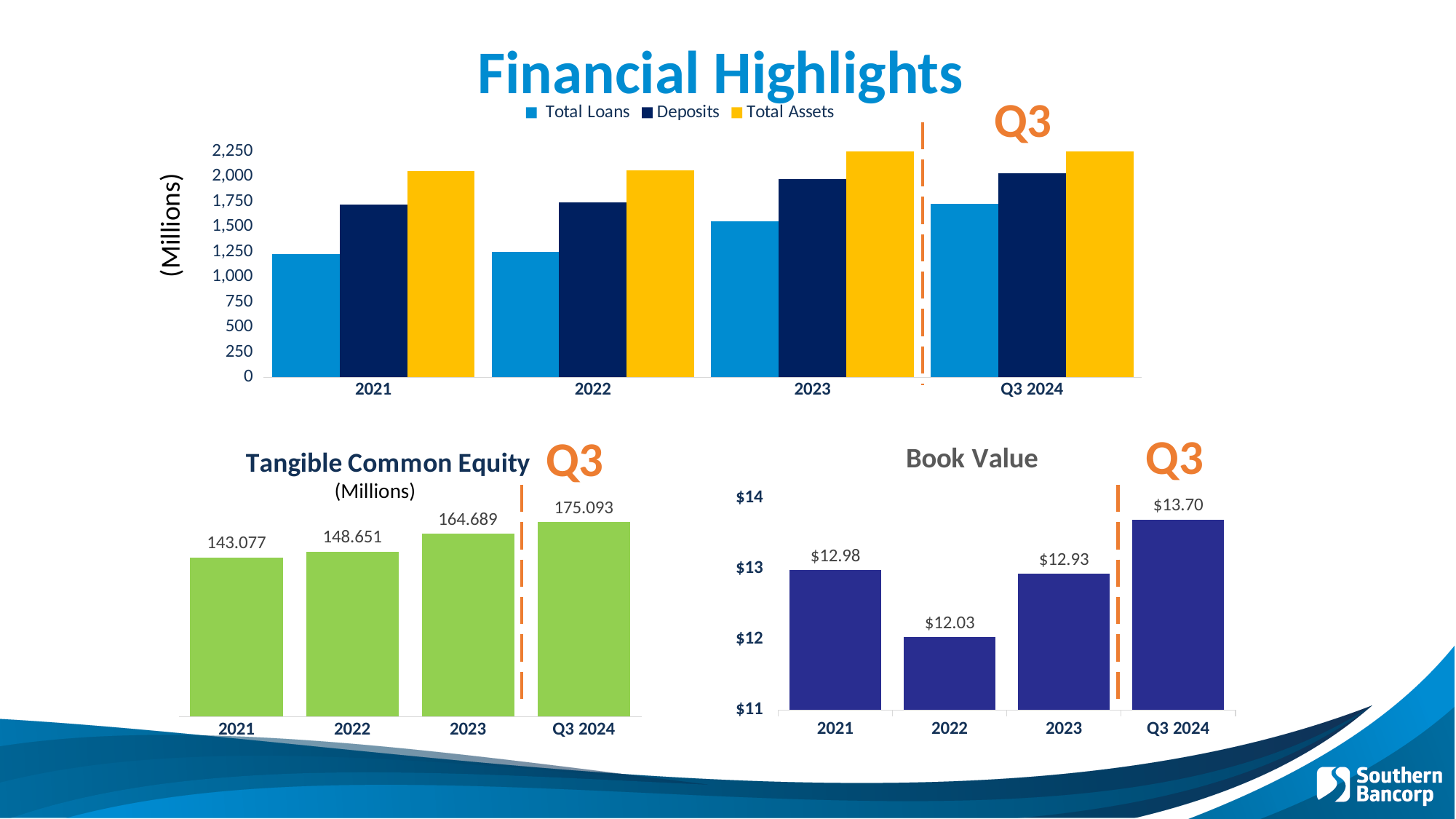
In the Tangible Common Equity chart, what is the value for 2021? 143.077 In the Financial Highlights chart at the top, is the Total Loans value for 2021 greater or less than 1,500? less In the Financial Highlights chart at the top, how many series does the legend list? 3 In the Tangible Common Equity chart, what is the difference between the 2023 and 2022 values? 16.038 What kind of chart is the Book Value chart? bar chart In the Book Value chart, which period has the lowest value? 2022 In the Tangible Common Equity chart, what is the value for Q3 2024? 175.093 In the Financial Highlights chart at the top, is the Total Assets value for 2023 greater or less than 2,000? greater In the Book Value chart, what is the value for 2022? $12.03 In the Tangible Common Equity chart, do the values rise or fall from 2021 to Q3 2024? rise In the Book Value chart, what is the difference between the Q3 2024 and 2021 values? $0.72 In the Book Value chart, which period has the highest value? Q3 2024